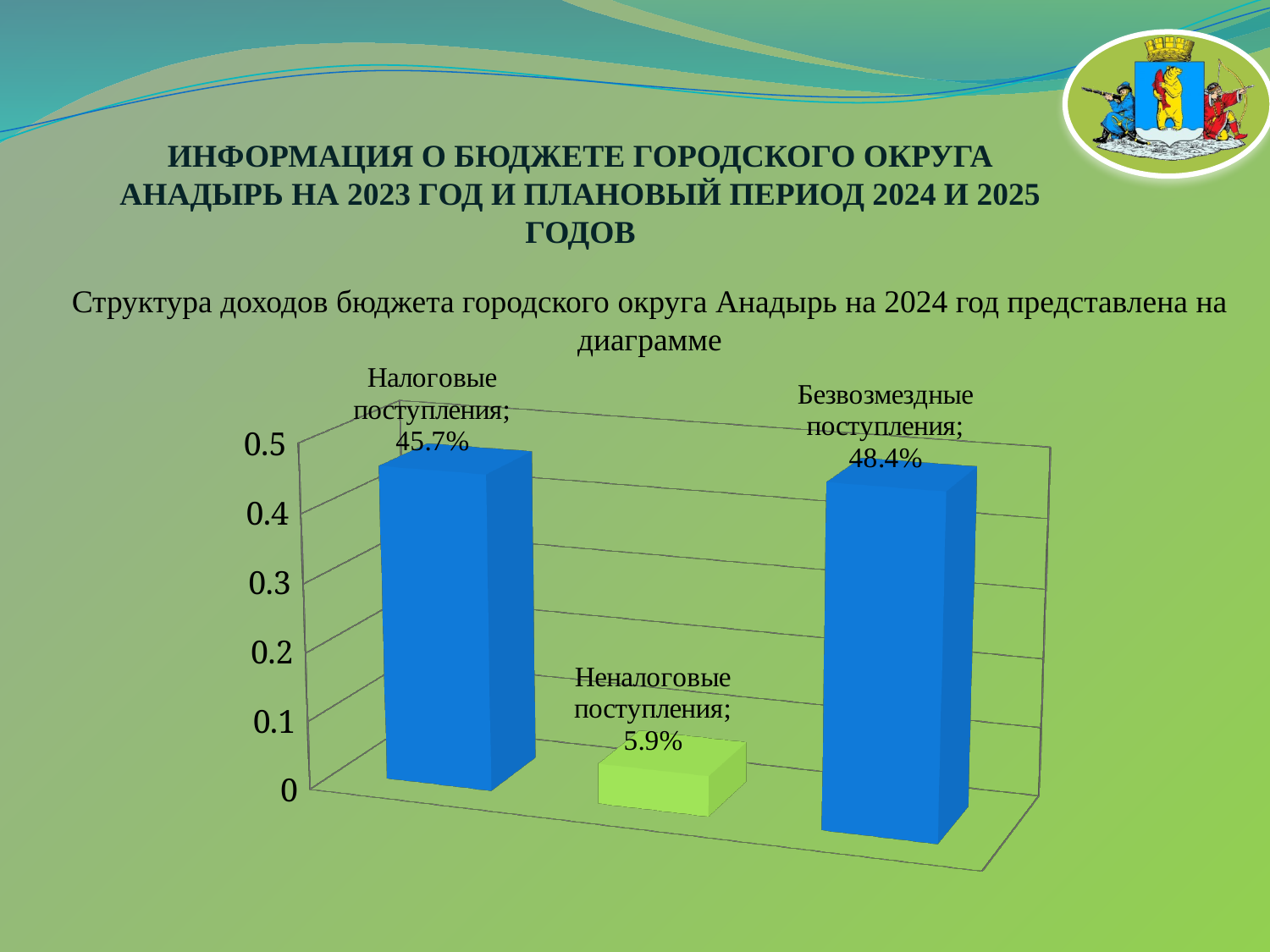
What is the highest tick value shown on the vertical axis? 0.5 How many categories are shown in the chart? 3 Which category has the lowest value? Неналоговые поступления Which is larger, Налоговые поступления or Неналоговые поступления? Налоговые поступления Is the value for Неналоговые поступления greater or less than 0.1? less What kind of chart is shown on the slide? bar chart What is the difference between Безвозмездные поступления and Налоговые поступления? 2.7% What is the value for Неналоговые поступления? 5.9% What is the difference between Налоговые поступления and Неналоговые поступления? 39.8% What is the value for Безвозмездные поступления? 48.4% What is the value for Налоговые поступления? 45.7% Which category has the highest value? Безвозмездные поступления